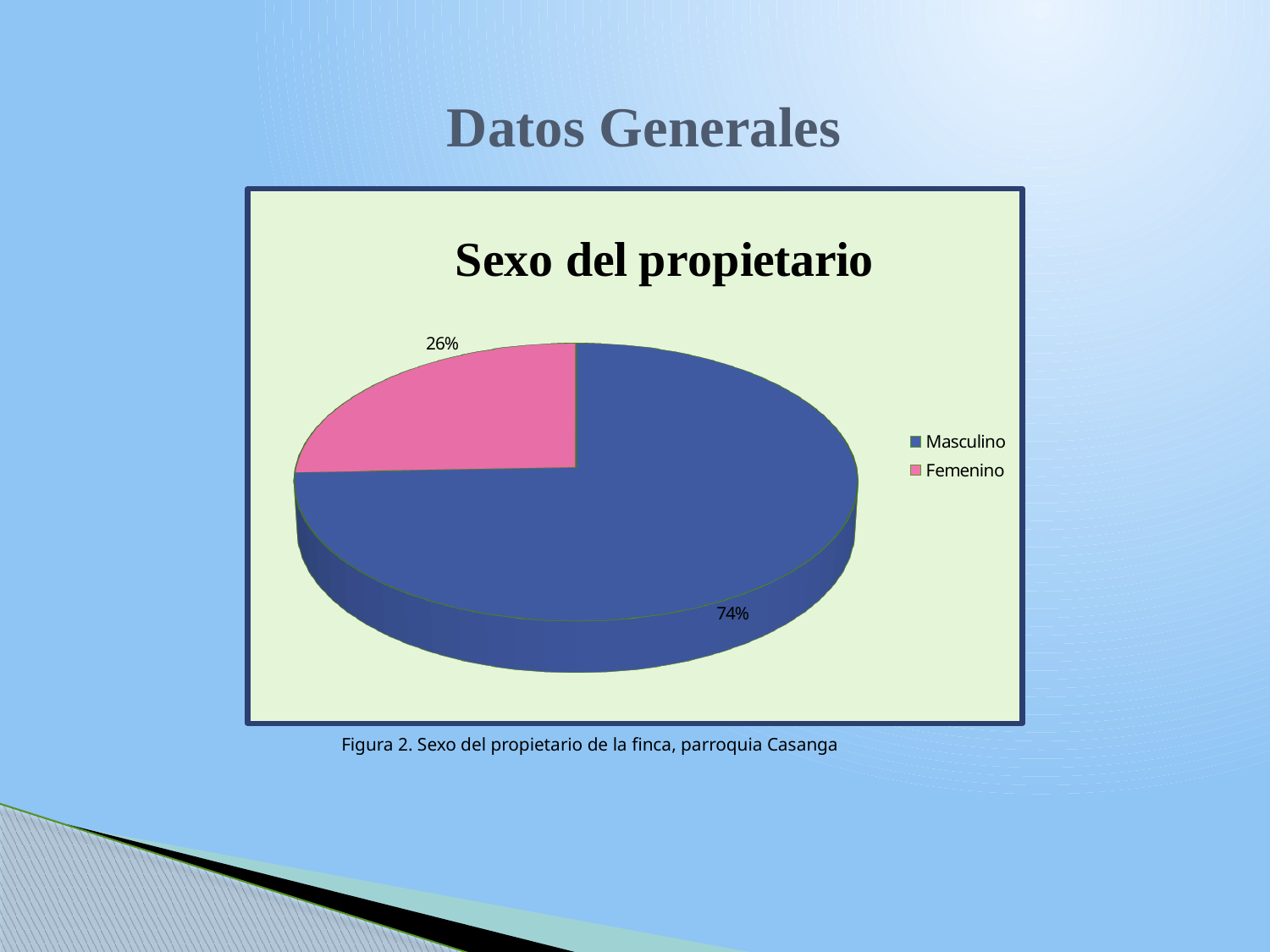
What percentage of the pie is Masculino? 74% What type of chart is shown on the slide? Pie chart What is the share of the pie for Masculino? 74% How many categories does the pie chart have? 2 What is the difference in percentage points between Masculino and Femenino? 48 Which category has the largest share of the pie? Masculino What is the title of the chart? Sexo del propietario What colour is the Femenino slice? Pink How many entries does the legend list? 2 Which is larger, the Masculino slice or the Femenino slice? Masculino Which category has the smallest share of the pie? Femenino What percentage of the pie is Femenino? 26%